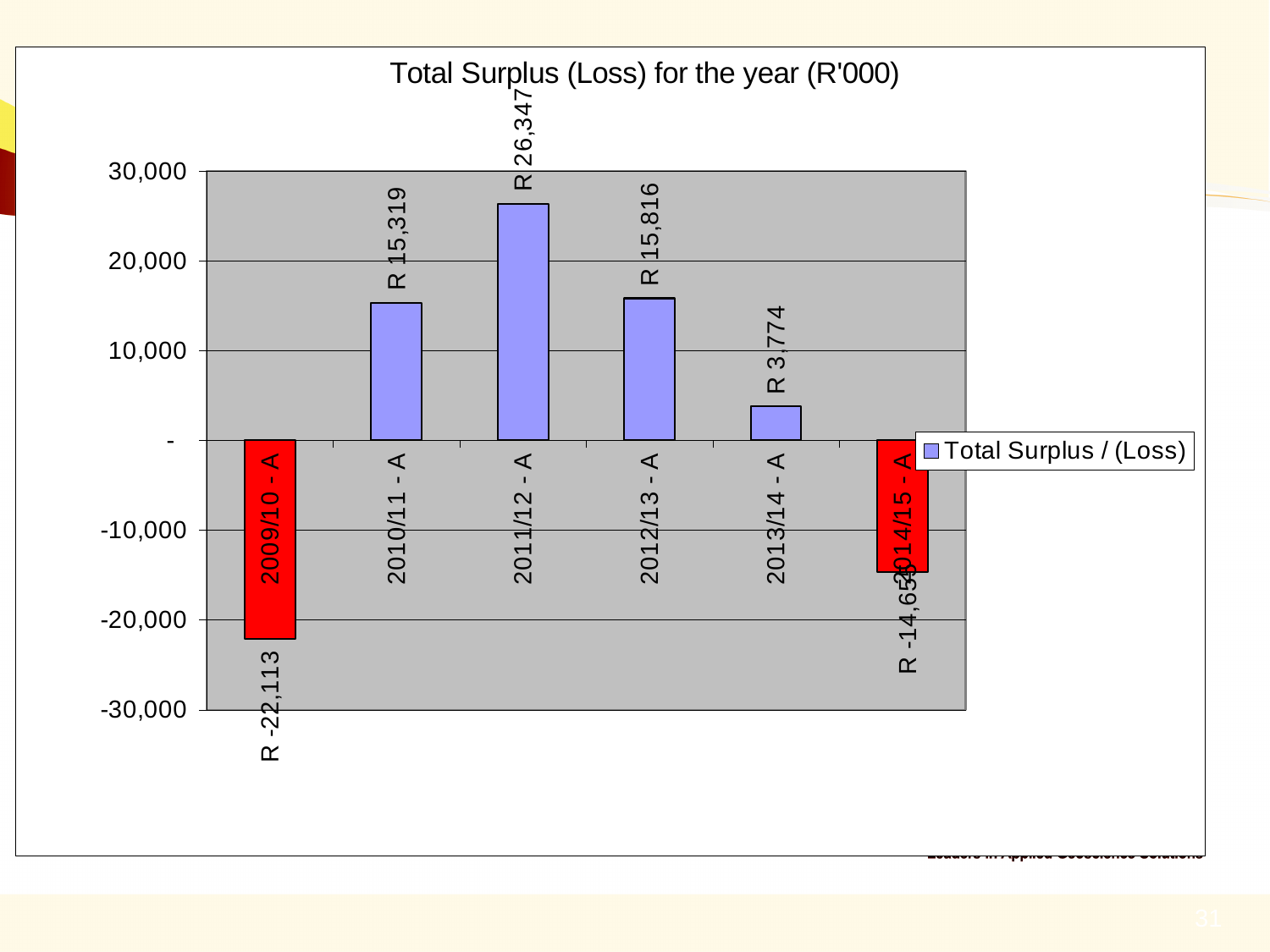
Which year has the lowest value (largest loss)? 2009/10 - A What is the difference between the values for 2011/12 - A and 2010/11 - A? R 11,028 What is the value for 2009/10 - A? R -22,113 How many series does the legend list? 1 What is the value for 2013/14 - A? R 3,774 Which is larger, the value for 2012/13 - A or 2010/11 - A? 2012/13 - A Is the value for 2014/15 - A greater or less than -10,000? less What is the title of the chart? Total Surplus (Loss) for the year (R'000) What kind of chart is shown on the slide? bar chart How many years are shown on the x axis? 6 What is the value for 2011/12 - A? R 26,347 Which year has the highest total surplus? 2011/12 - A